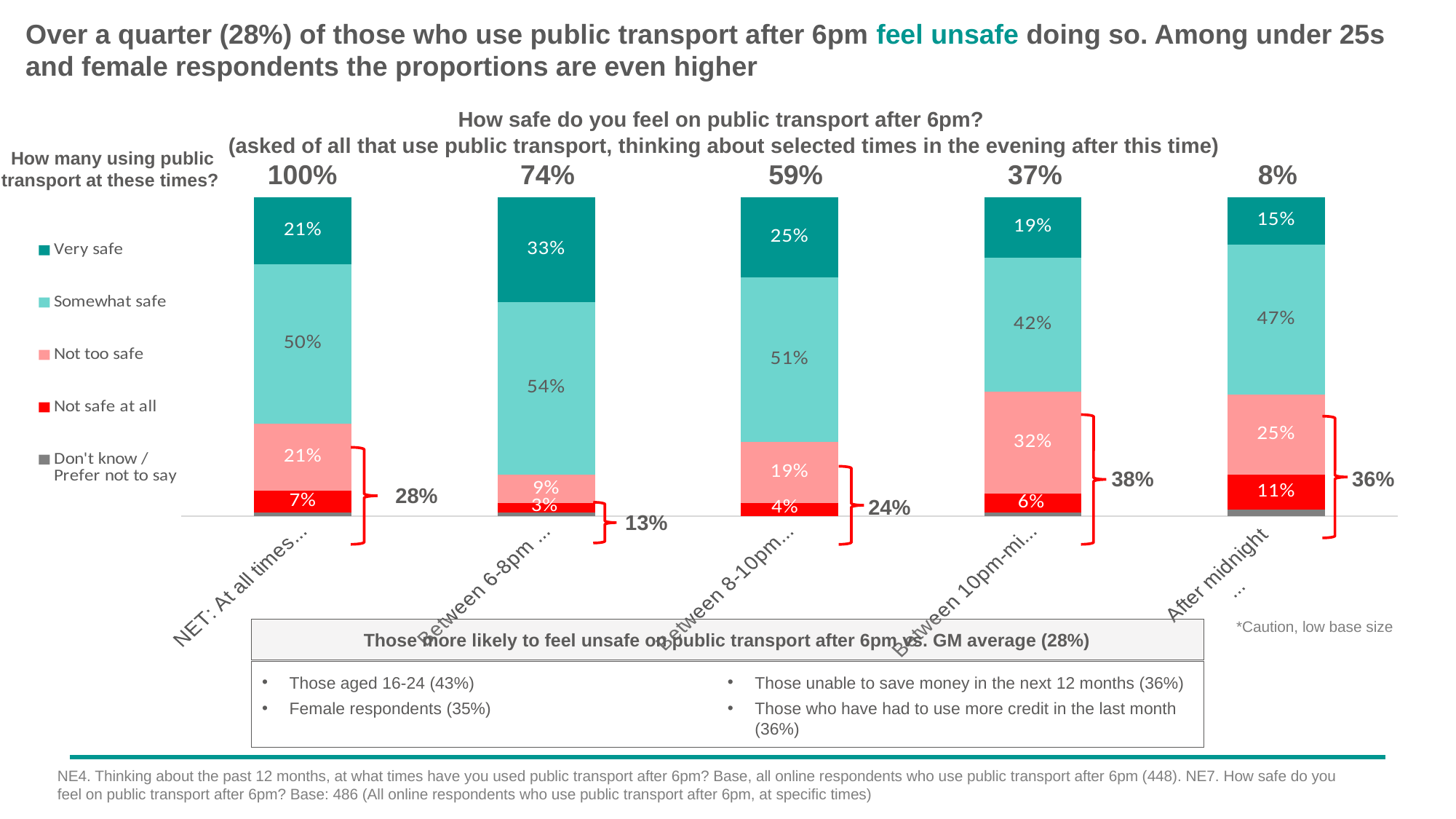
How many response categories does the legend list? 5 How many time-period bars are shown in the chart? 5 Which time period has the lowest percentage of respondents feeling not safe at all? Between 6-8pm What percentage of respondents use public transport after midnight, as shown above the bar? 8% What percentage of respondents said they feel very safe on public transport between 6-8pm? 33% What percentage said they feel not too safe on public transport between 10pm and midnight? 32% What combined unsafe percentage is shown by the bracket for the between 10pm-midnight bar? 38% What type of chart is used to show how safe people feel on public transport after 6pm? Stacked bar chart Does the not safe at all share rise or fall moving from between 6-8pm to after midnight? Rises Which has a larger not too safe share: after midnight or between 8-10pm? After midnight Which time period has the highest percentage of respondents feeling somewhat safe? Between 6-8pm How many percentage points higher is the very safe share for between 6-8pm than for NET: At all times? 12 percentage points